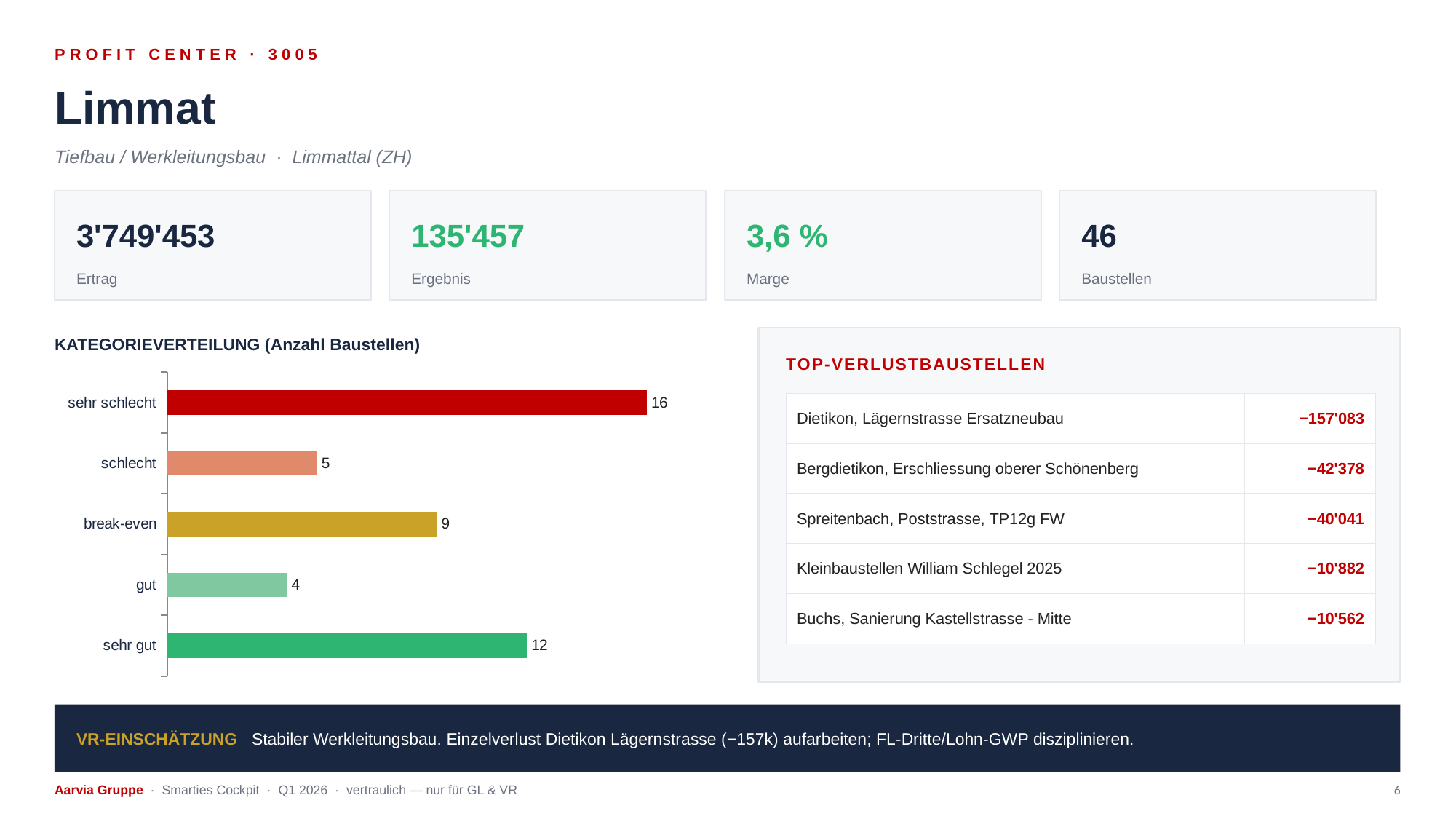
What type of chart is the KATEGORIEVERTEILUNG chart? bar chart In the KATEGORIEVERTEILUNG chart, which category has the lowest number of Baustellen? gut In the KATEGORIEVERTEILUNG chart, which category has the highest number of Baustellen? sehr schlecht In the KATEGORIEVERTEILUNG chart, what is the value for 'break-even'? 9 In the KATEGORIEVERTEILUNG chart, what is the difference between 'break-even' and 'schlecht'? 4 In the KATEGORIEVERTEILUNG chart, what is the value for 'sehr gut'? 12 In the KATEGORIEVERTEILUNG chart, what is the difference between 'sehr schlecht' and 'sehr gut'? 4 How many categories are shown in the KATEGORIEVERTEILUNG chart? 5 What is the total number of Baustellen across all categories in the KATEGORIEVERTEILUNG chart? 46 In the KATEGORIEVERTEILUNG chart, how many Baustellen are in the 'sehr schlecht' category? 16 What colour is the 'sehr schlecht' bar in the KATEGORIEVERTEILUNG chart? red In the KATEGORIEVERTEILUNG chart, which is larger: 'schlecht' or 'gut'? schlecht